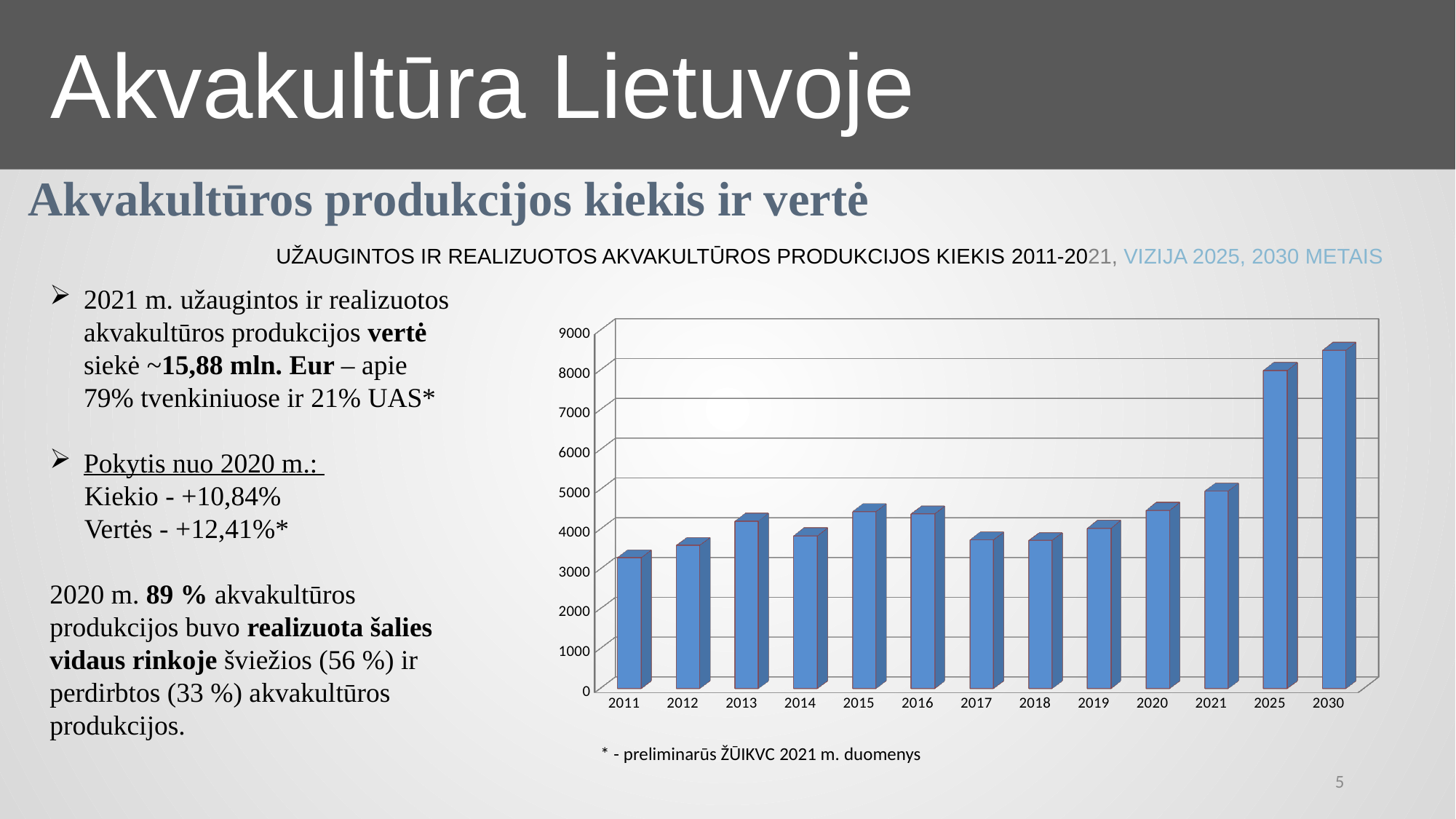
Is the value for 2018 greater or less than 4000? less Is the value for 2021 greater or less than 4000? greater How many years (categories) are shown on the x axis of the chart? 13 Is the value for 2025 greater or less than 7000? greater Which year has the lowest bar in the chart? 2011 What kind of chart is shown on the slide? bar chart Which is larger, the value for 2013 or the value for 2012? 2013 Do the values rise or fall from 2021 to 2030 along the x axis? rise Which is larger, the value for 2025 or the value for 2021? 2025 Which year has the highest bar in the chart? 2030